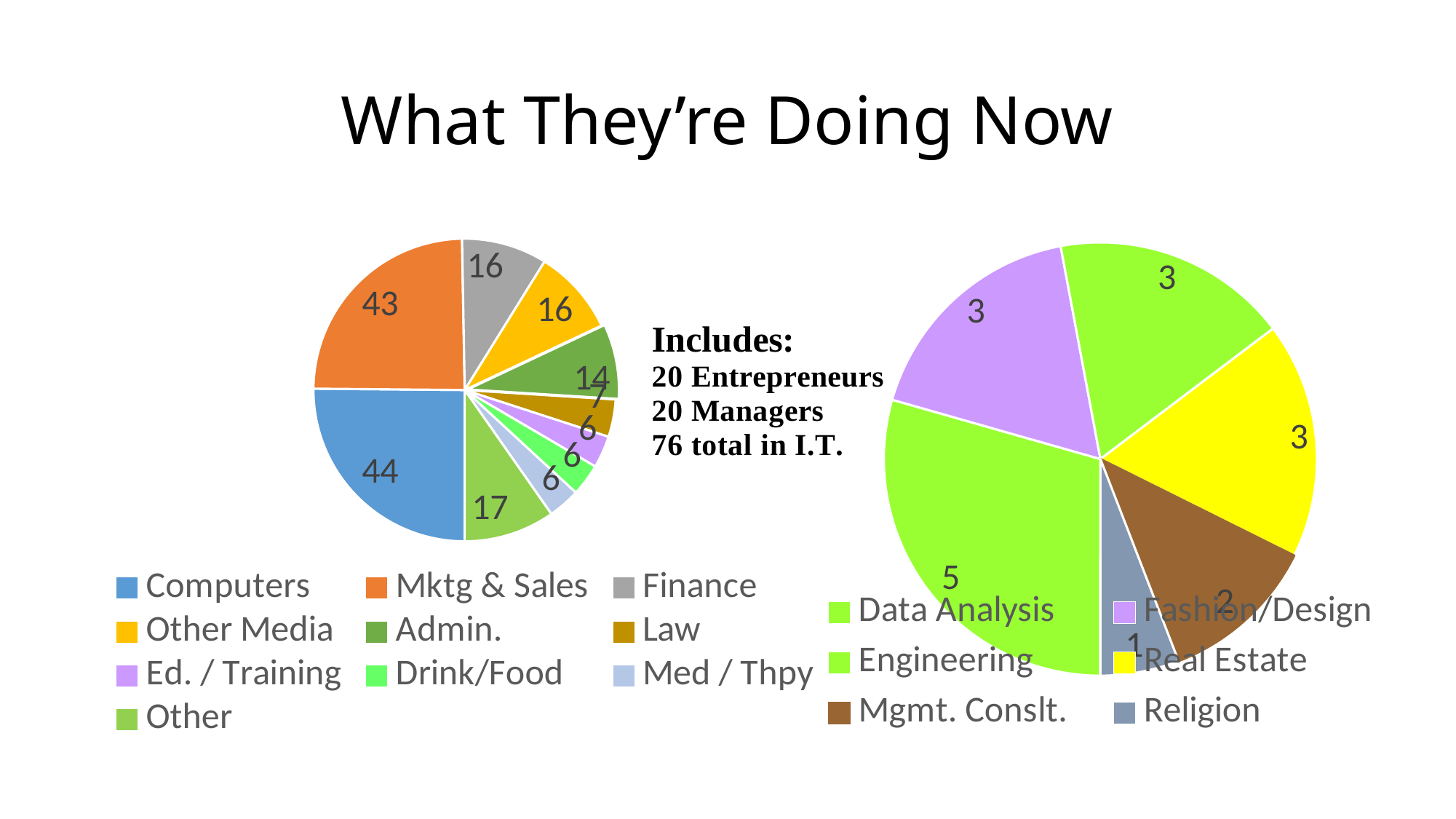
In the left pie chart, which is larger, Admin. or Law? Admin. In the left pie chart, what is the value for Computers? 44 In the left pie chart, which category has the largest slice? Computers How many categories does the legend of the right pie chart list? 6 In the right pie chart, what is the value for Mgmt. Conslt.? 2 In the right pie chart, what is the value for Data Analysis? 5 What type of chart is shown on the left of the slide? Pie chart In the left pie chart, what is the difference between the values for Other and Finance? 1 In the left pie chart, what is the value for Mktg & Sales? 43 What is the title of the slide? What They're Doing Now In the right pie chart, which category has the smallest slice? Religion In the left pie chart, what is the value for Admin.? 14